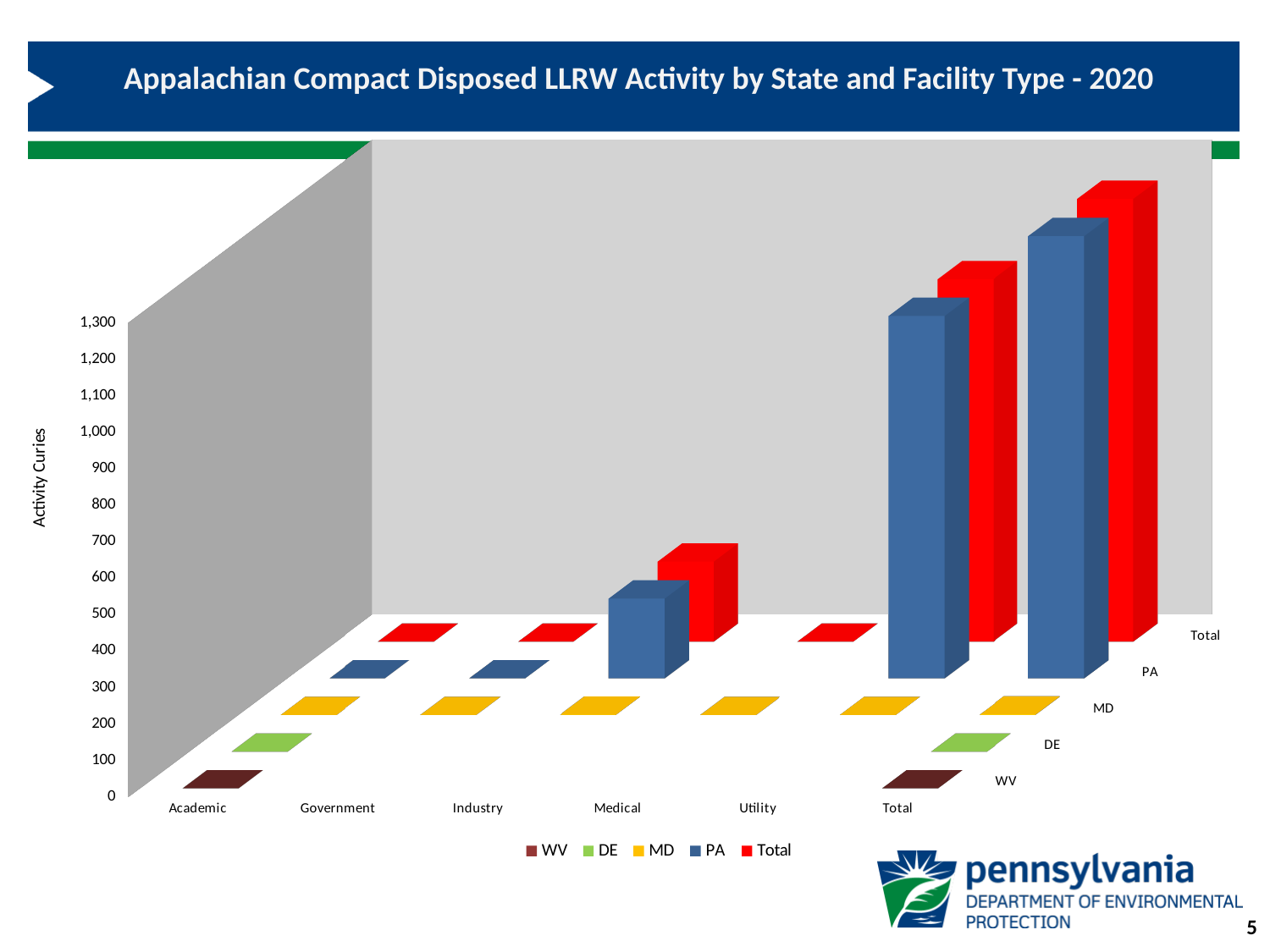
Is the Total value for the Total category greater or less than 500? greater How many categories are shown along the x axis? 6 Is the PA value for the Total category greater or less than 500? greater How many series does the legend list? 5 What is the label on the vertical axis? Activity Curies What kind of chart is shown on the slide? bar chart Which category has the tallest Total bar? Total Is the Total value for Utility greater or less than 500? greater Which state series shows the largest activity in the Total category? PA What is the title of the chart? Appalachian Compact Disposed LLRW Activity by State and Facility Type - 2020 Among the facility types Academic, Government, Industry, Medical and Utility, which has the highest PA activity? Utility